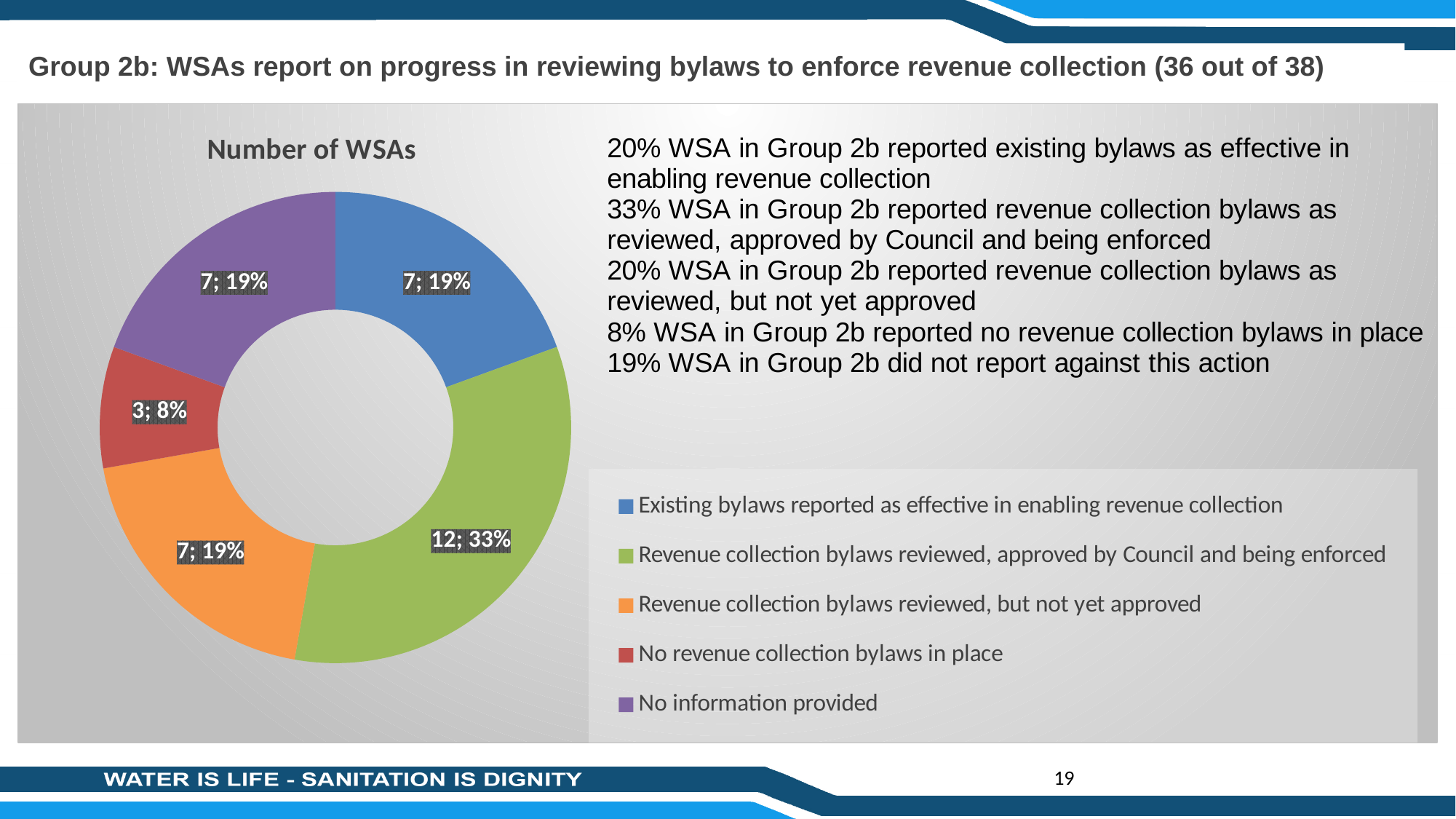
What share of the chart is 'No revenue collection bylaws in place'? 8% Which category has the largest slice? Revenue collection bylaws reviewed, approved by Council and being enforced Which colour represents 'No information provided' in the chart? Purple How many WSAs reported no revenue collection bylaws in place? 3 What is the difference between the number of WSAs with bylaws approved and being enforced and the number with no bylaws in place? 9 What is the title of the chart? Number of WSAs How many categories does the legend list? 5 Which category has the smallest slice? No revenue collection bylaws in place What share of the chart is 'Revenue collection bylaws reviewed, but not yet approved'? 19% How many WSAs reported revenue collection bylaws reviewed, approved by Council and being enforced? 12 What kind of chart is shown on the slide? Doughnut (pie) chart How many WSAs provided no information? 7